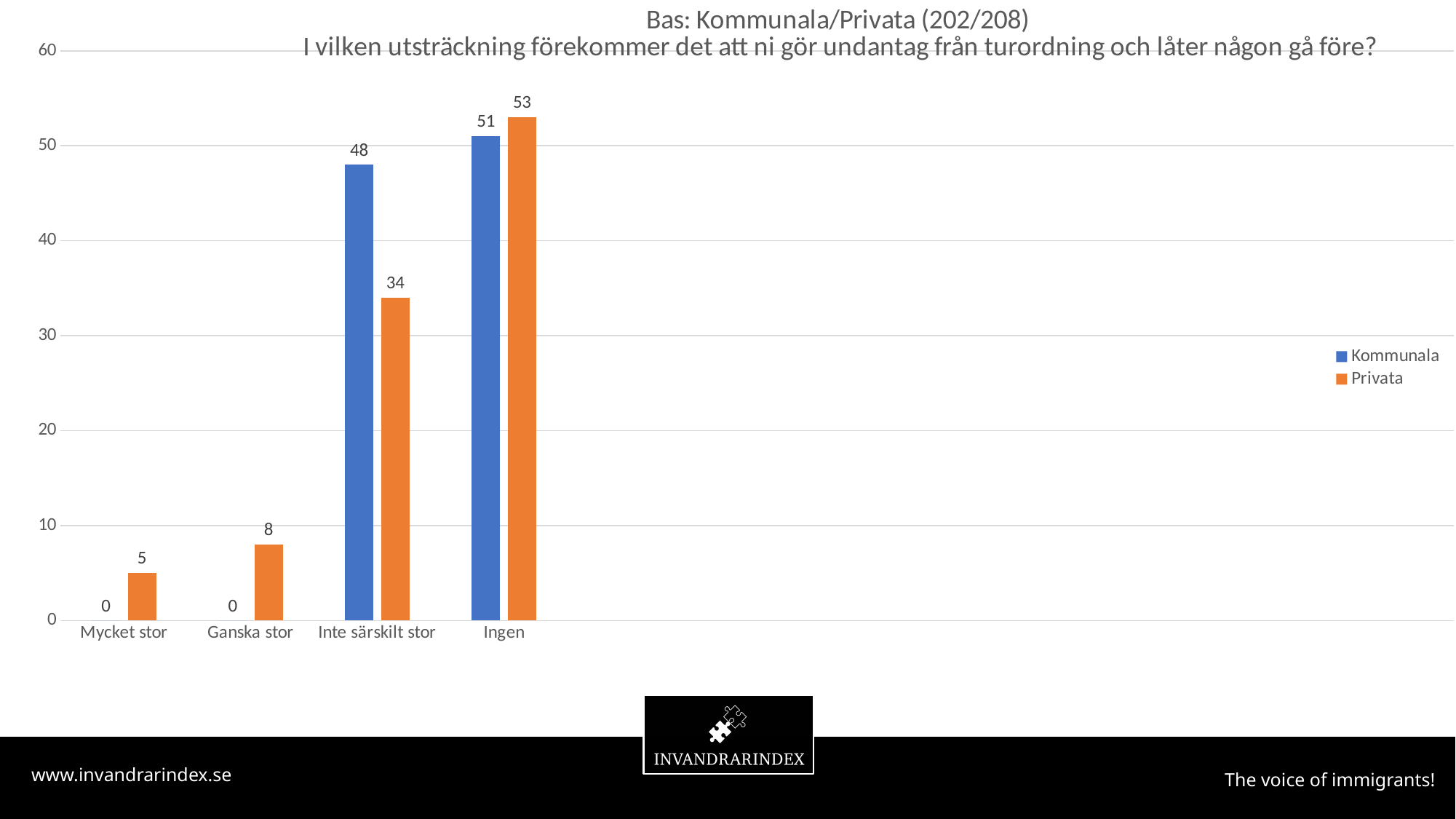
What is the value for Privata in the Mycket stor category? 5 Which category has the highest value for the Privata series? Ingen How many categories are shown on the x axis? 4 What is the difference between Kommunala and Privata in the Inte särskilt stor category? 14 In the Ingen category, which series has the larger value, Kommunala or Privata? Privata What is the value for Privata in the Ingen category? 53 Which category has the lowest value for the Privata series? Mycket stor What is the value for Kommunala in the Ganska stor category? 0 Which colour represents the Privata series? Orange How many series does the legend list? 2 What kind of chart is shown on the slide? Bar chart What is the value for Kommunala in the Inte särskilt stor category? 48